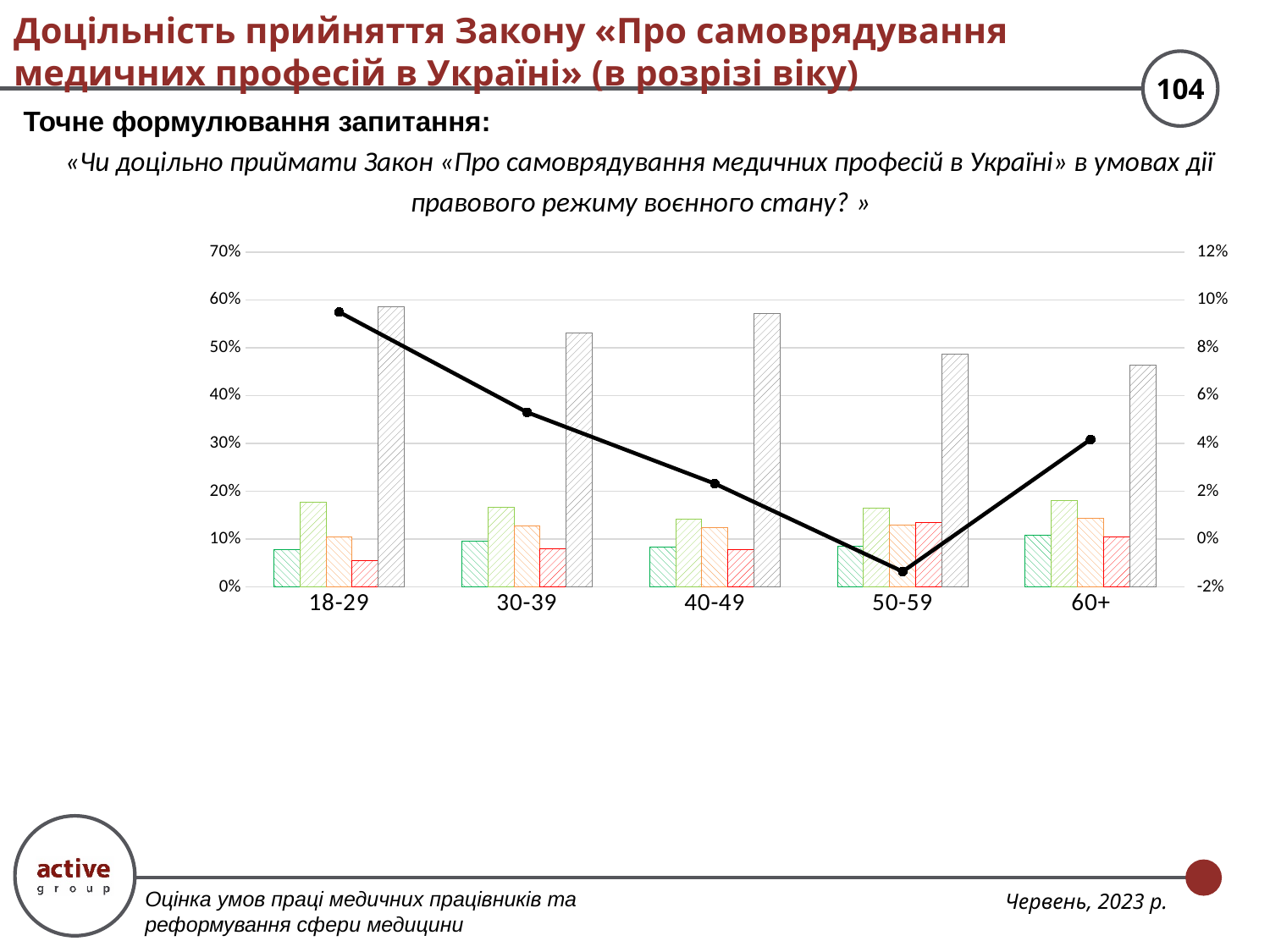
What kind of chart is shown on the slide? A combined bar and line chart On the right-hand axis, is the black line's value for the 50-59 category greater or less than 0%? less For which age category does the black line reach its lowest point? 50-59 On the right-hand axis, is the black line's value for the 40-49 category greater or less than 4%? less How does the black line change from the 18-29 category to the 50-59 category? It falls For which age category does the black line reach its highest point? 18-29 Is the value of the tallest (grey hatched) bar for the 50-59 category greater or less than 40%? greater How many age categories are shown on the x axis of the chart? 5 How many bars are plotted for each age category in the chart? 5